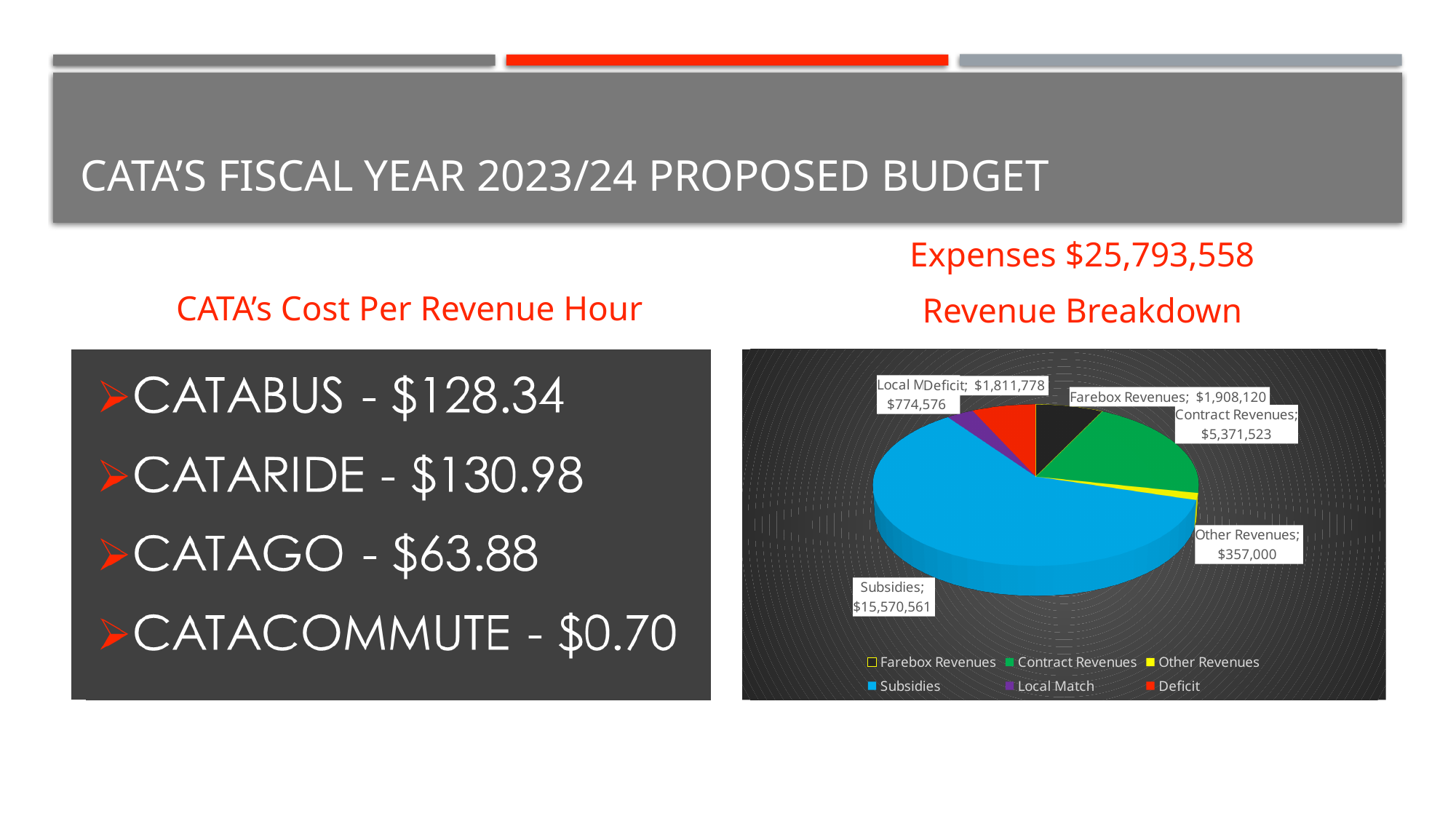
In the Revenue Breakdown pie chart, what is the difference between Contract Revenues and Farebox Revenues? $3,463,403 In the Revenue Breakdown pie chart, which category has the smallest slice? Other Revenues In the Revenue Breakdown pie chart, what is the value for Contract Revenues? $5,371,523 What type of chart is shown under the Revenue Breakdown heading? Pie chart In the Revenue Breakdown pie chart, what is the value for Local Match? $774,576 In the Revenue Breakdown pie chart, which is larger: Contract Revenues or Farebox Revenues? Contract Revenues In the Revenue Breakdown pie chart, what is the value for Deficit? $1,811,778 In the Revenue Breakdown pie chart, what is the value for Subsidies? $15,570,561 How many slices does the Revenue Breakdown pie chart have? 6 In the Revenue Breakdown pie chart, which category has the largest slice? Subsidies How many entries does the legend of the Revenue Breakdown pie chart list? 6 In the Revenue Breakdown pie chart, what colour is the Subsidies slice? Blue